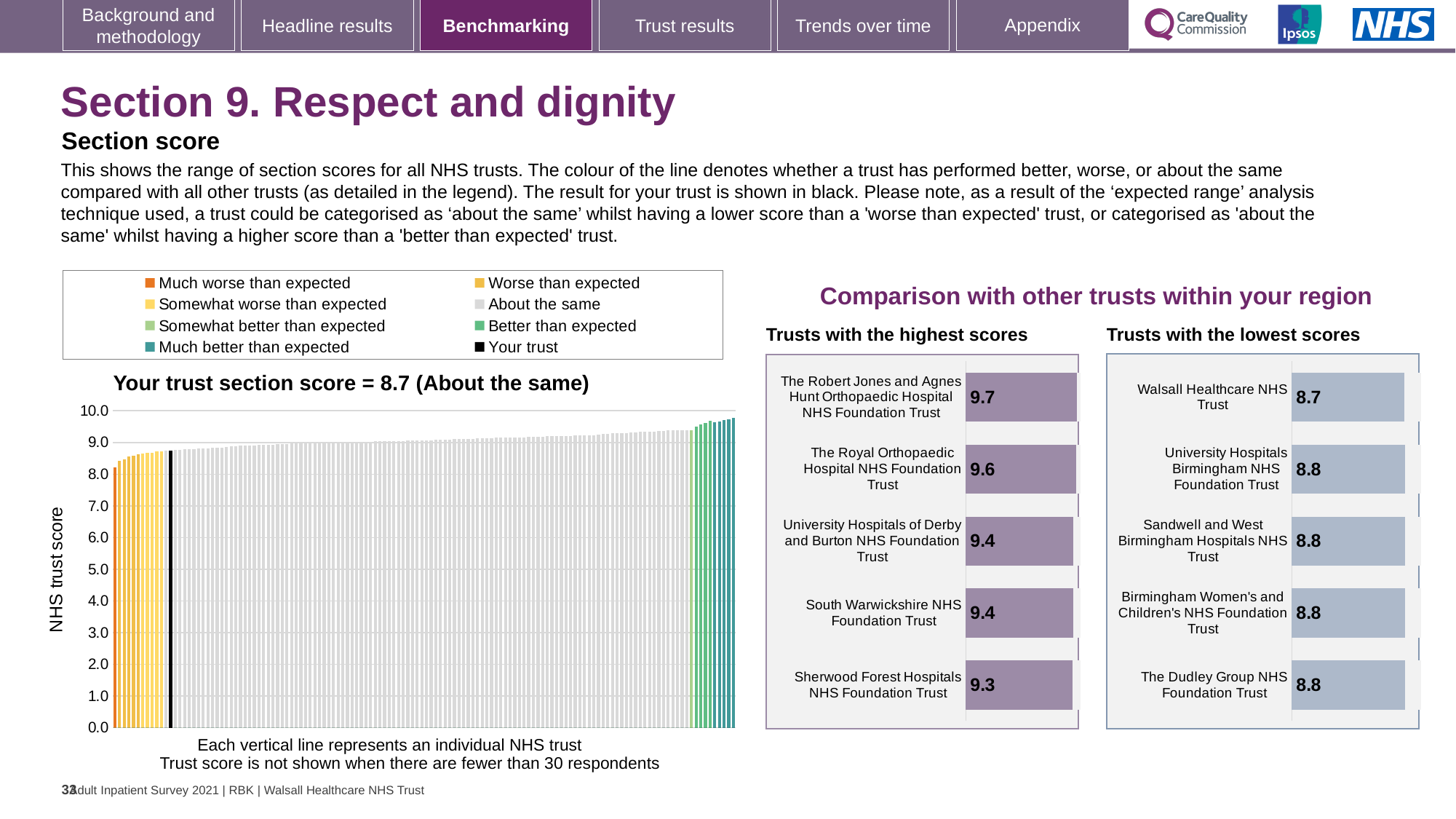
In the 'Trusts with the highest scores' chart, what is the score for The Royal Orthopaedic Hospital NHS Foundation Trust? 9.6 In the 'Trusts with the highest scores' chart, which trust has the highest score? The Robert Jones and Agnes Hunt Orthopaedic Hospital NHS Foundation Trust In the 'Your trust section score' chart, is the value for the rightmost trust greater or less than 9.0? greater In the 'Your trust section score' chart, what kind of chart is shown? bar chart In the 'Your trust section score' chart, what is the section score for your trust? 8.7 In the 'Your trust section score' chart, how many entries does the legend list? 8 In the 'Trusts with the highest scores' chart, what is the difference between the scores of The Robert Jones and Agnes Hunt Orthopaedic Hospital NHS Foundation Trust and Sherwood Forest Hospitals NHS Foundation Trust? 0.4 In the 'Trusts with the lowest scores' chart, what is the score for The Dudley Group NHS Foundation Trust? 8.8 In the 'Your trust section score' chart, do the trust scores rise or fall from left to right? rise In the 'Trusts with the lowest scores' chart, which trust has the lowest score? Walsall Healthcare NHS Trust In the 'Your trust section score' chart, what is the label on the vertical axis? NHS trust score In the 'Trusts with the highest scores' chart, how many trusts are listed? 5